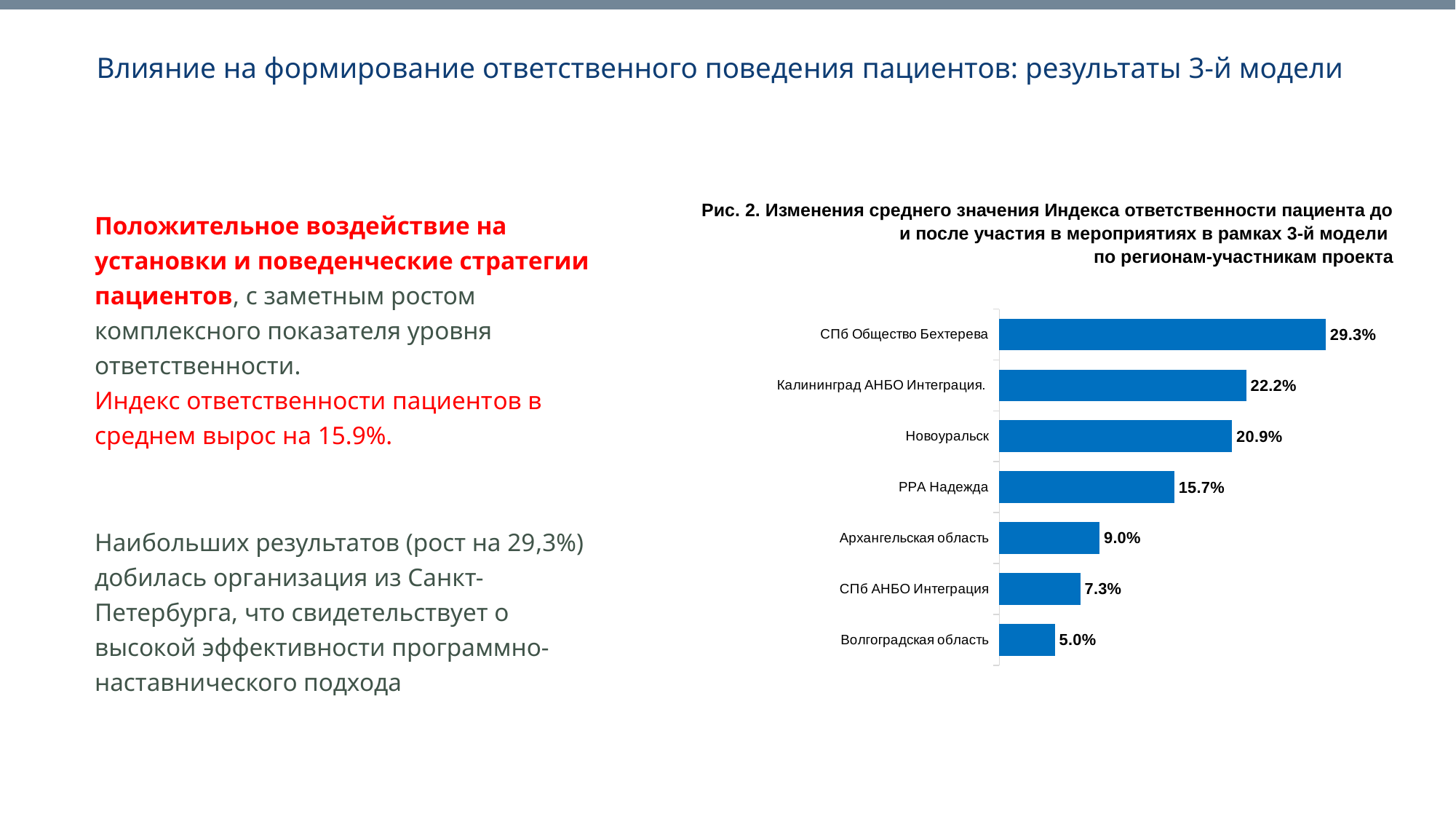
What is the value for Новоуральск? 20.9% What kind of chart is shown on the slide? Bar chart What is the difference between the values for СПб Общество Бехтерева and Волгоградская область? 24.3% What is the value for РРА Надежда? 15.7% Which is larger, the value for СПб АНБО Интеграция or the value for Волгоградская область? СПб АНБО Интеграция Which category has the highest value? СПб Общество Бехтерева How many categories are shown in the chart? 7 What is the difference between the values for Калининград АНБО Интеграция. and РРА Надежда? 6.5% What is the value for СПб Общество Бехтерева? 29.3% What is the value for Архангельская область? 9.0% What is the figure number given in the chart title? Рис. 2 Which category has the lowest value? Волгоградская область